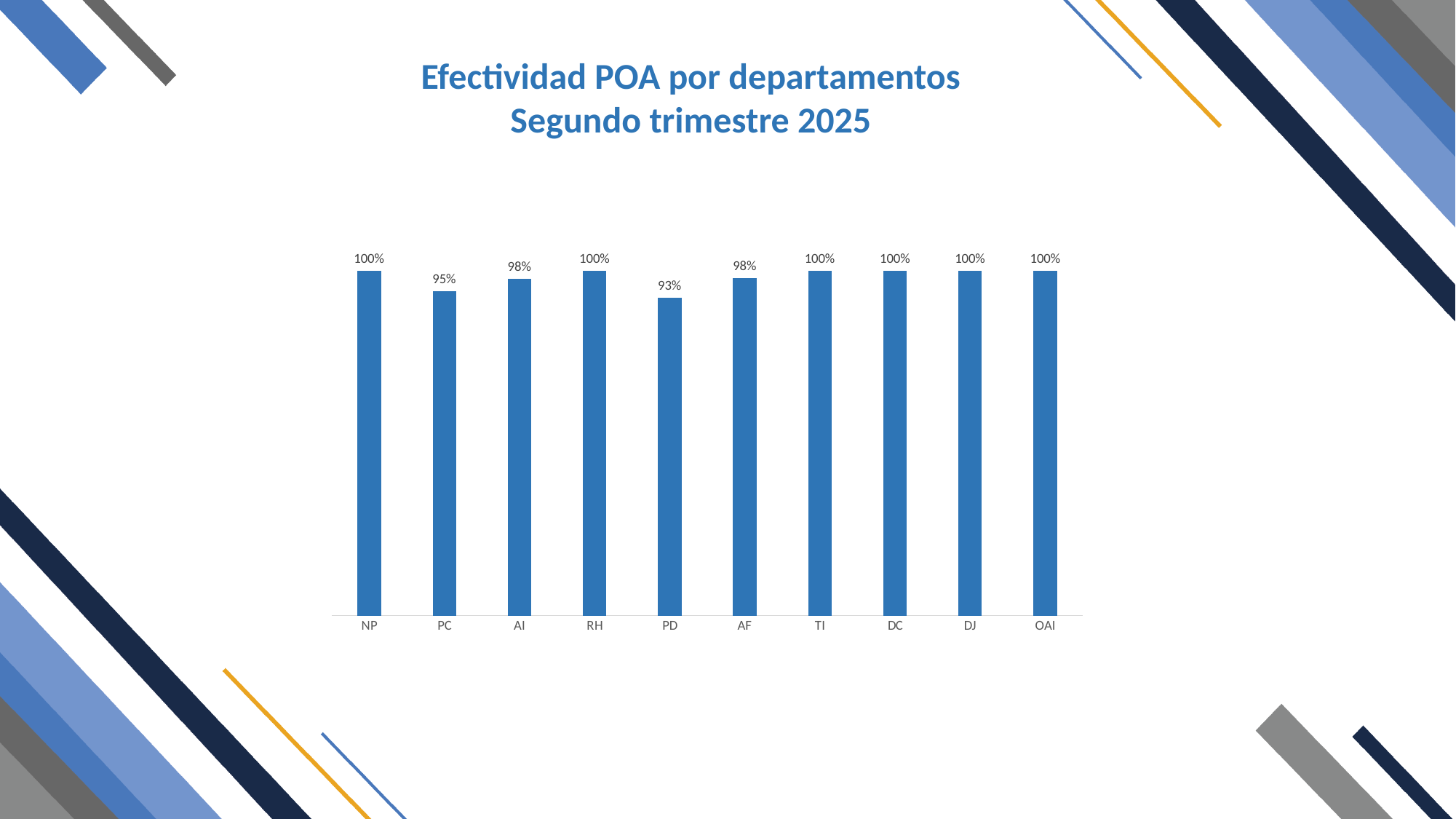
What is the difference between the values for AI and PC? 3% What is the value for PC? 95% What kind of chart is shown on the slide? bar chart What is the difference between the values for NP and PD? 7% What is the value for AF? 98% Which department has the lowest value? PD What is the value for AI? 98% What is the title of the chart? Efectividad POA por departamentos Segundo trimestre 2025 Which is larger, the value for PD or the value for RH? RH What is the value for PD? 93% How many departments are shown on the x axis? 10 Which is larger, the value for PC or the value for AF? AF